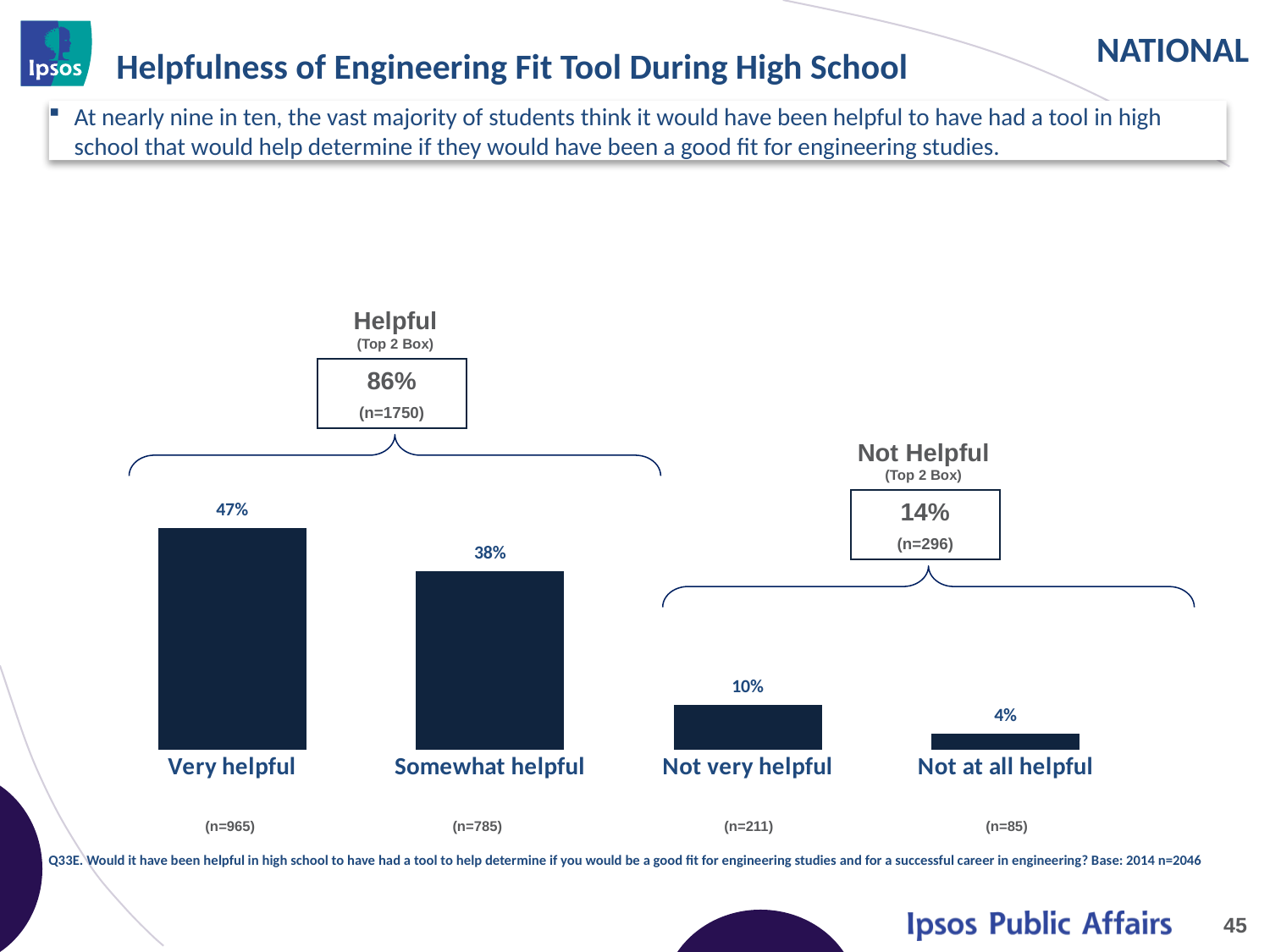
What is the sample size (n) shown for the Not Helpful (Top 2 Box) group? n=296 What kind of chart is shown on the slide? Bar chart What is the difference in percentage points between Very helpful and Somewhat helpful? 9 How many response categories are shown as bars in the chart? 4 What percentage of students said a tool would have been not very helpful? 10% What percentage of students said a tool would have been somewhat helpful? 38% What is the Helpful (Top 2 Box) percentage shown above the chart? 86% Which response category has the highest percentage? Very helpful What percentage of students said a tool would have been not at all helpful? 4% Which response category has the lowest percentage? Not at all helpful What percentage of students said a tool would have been very helpful? 47% Which is larger, the percentage for Not very helpful or for Not at all helpful? Not very helpful